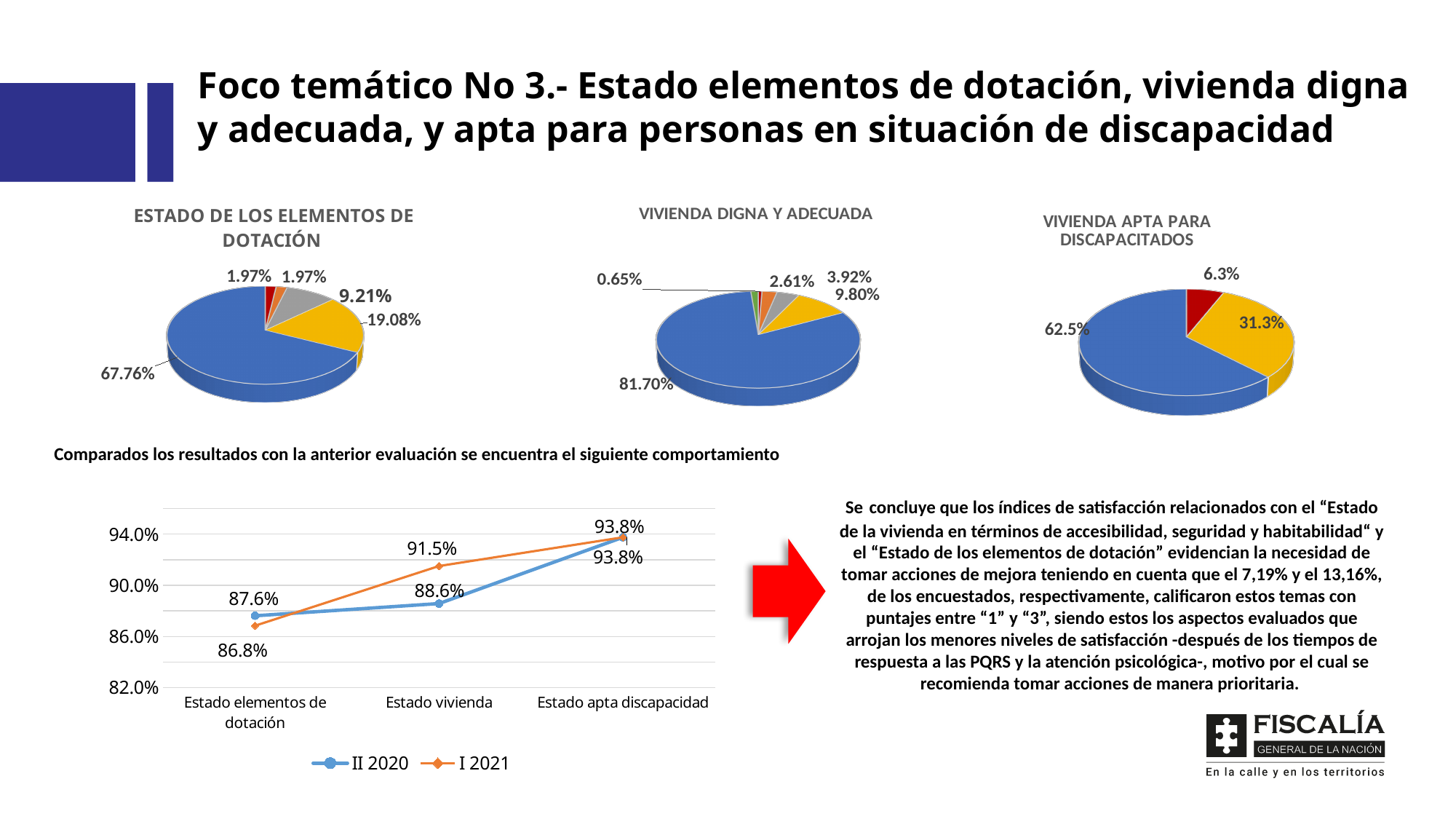
In the line chart at the bottom left, what is the value for I 2021 at Estado vivienda? 91.5% In the line chart at the bottom left, what is the value for II 2020 at Estado elementos de dotación? 87.6% How many series does the legend of the line chart at the bottom left list? 2 How many slices does the pie chart titled VIVIENDA APTA PARA DISCAPACITADOS have? 3 In the line chart at the bottom left, what is the difference between the I 2021 and II 2020 values at Estado vivienda? 2.9 percentage points What kind of chart is the chart at the bottom left comparing II 2020 and I 2021? Line chart In the pie chart titled VIVIENDA DIGNA Y ADECUADA, what is the value of the smallest slice? 0.65% In the pie chart titled ESTADO DE LOS ELEMENTOS DE DOTACIÓN, what is the value of the largest slice? 67.76% In the line chart at the bottom left, which series has the higher value at Estado elementos de dotación, II 2020 or I 2021? II 2020 In the pie chart titled VIVIENDA APTA PARA DISCAPACITADOS, what is the value of the largest slice? 62.5% How many categories are shown on the x axis of the line chart at the bottom left? 3 In the line chart at the bottom left, do the I 2021 values rise or fall from Estado elementos de dotación to Estado apta discapacidad? Rise